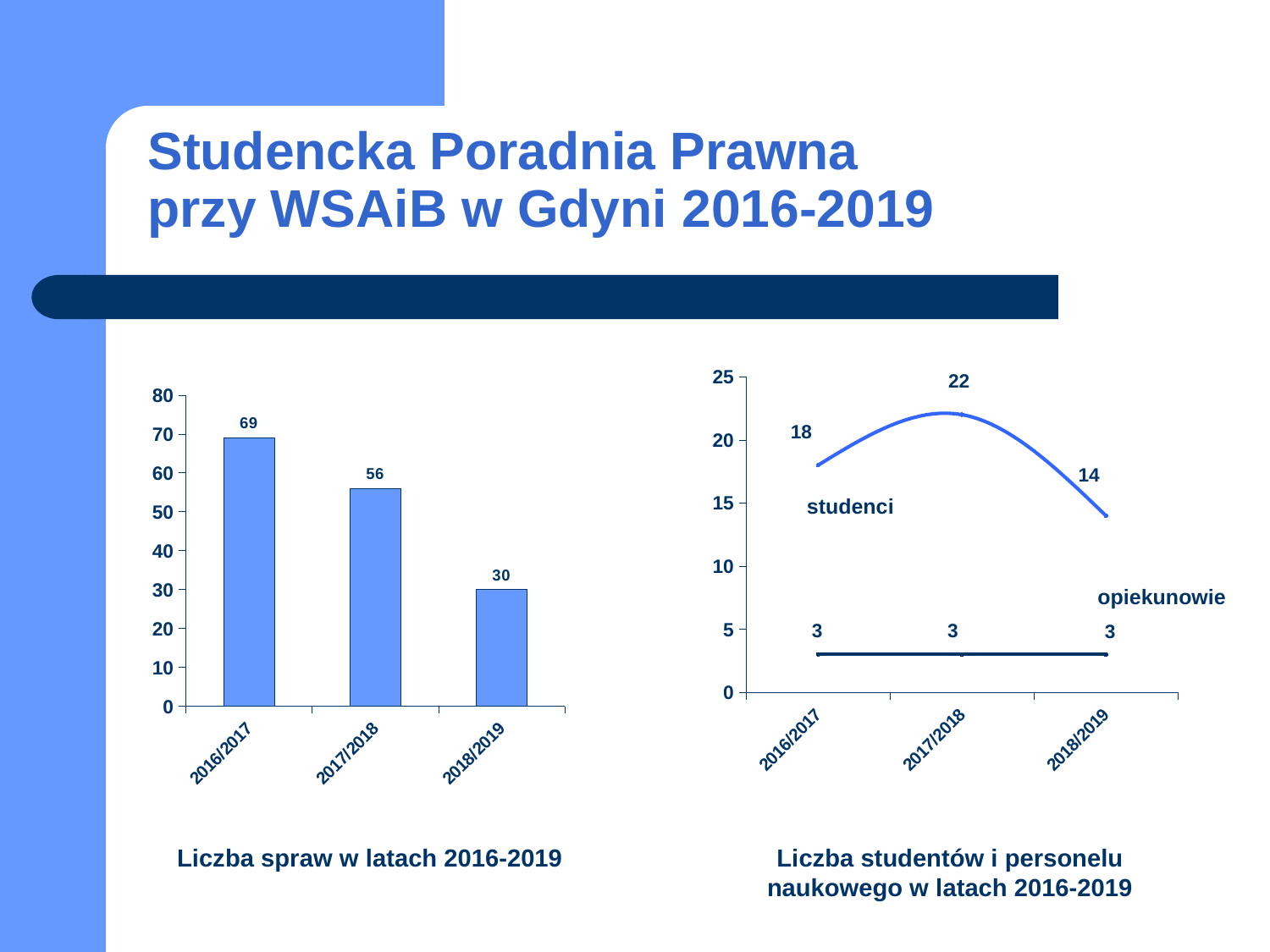
In the left chart (Liczba spraw w latach 2016-2019), do the values rise or fall from 2016/2017 to 2018/2019? fall How many series are plotted in the right chart (Liczba studentów i personelu naukowego w latach 2016-2019)? 2 What kind of chart is the left chart (Liczba spraw w latach 2016-2019)? bar chart In the left chart (Liczba spraw w latach 2016-2019), what is the value for 2018/2019? 30 What kind of chart is the right chart (Liczba studentów i personelu naukowego w latach 2016-2019)? line chart In the right chart (Liczba studentów i personelu naukowego w latach 2016-2019), what is the difference between studenci and opiekunowie in 2016/2017? 15 In the right chart (Liczba studentów i personelu naukowego w latach 2016-2019), what is the value for studenci in 2017/2018? 22 In the left chart (Liczba spraw w latach 2016-2019), which year has the lowest value? 2018/2019 In the right chart (Liczba studentów i personelu naukowego w latach 2016-2019), what is the value for opiekunowie in 2018/2019? 3 In the left chart (Liczba spraw w latach 2016-2019), what is the difference between the values for 2016/2017 and 2017/2018? 13 In the right chart (Liczba studentów i personelu naukowego w latach 2016-2019), in which year is the studenci value highest? 2017/2018 In the left chart (Liczba spraw w latach 2016-2019), what is the value for 2016/2017? 69